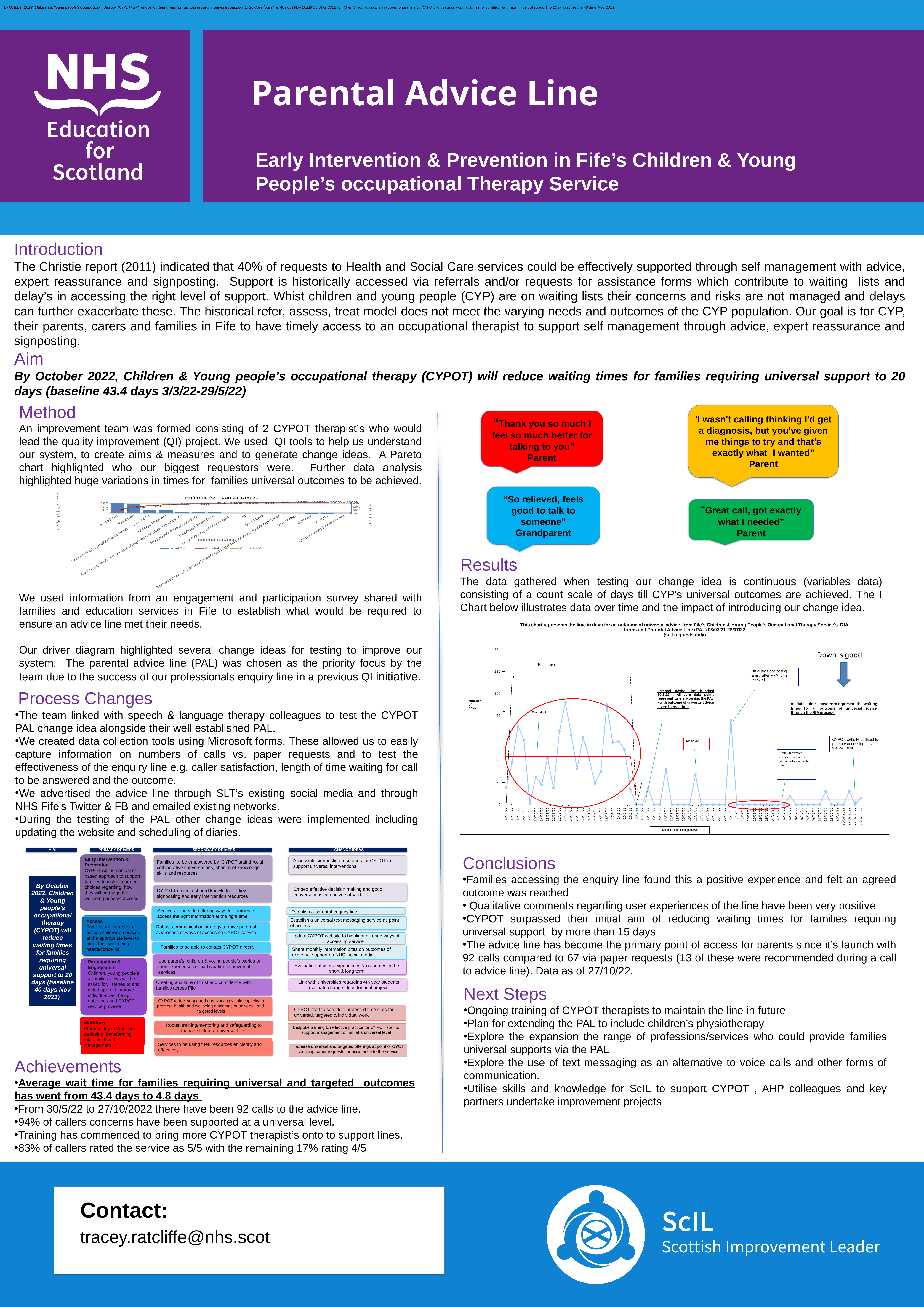
What kind of chart is the chart in the Results section showing time in days for an outcome of universal advice? line chart In the Referrals (OT) Jan 21-Dec 21 chart, how many series does the legend list? 3 In the Referrals (OT) Jan 21-Dec 21 chart, which referral source has the highest number of referrals? Self-referral What is the x-axis label of the Results chart? Date of request In the Results chart, what is the difference between the baseline mean and the post-launch mean? 38.6 What is the title of the chart in the Method section? Referrals (OT) Jan 21-Dec 21 In the Results chart, what is the mean of the baseline data? 43.4 In the Referrals (OT) Jan 21-Dec 21 chart, is the bar for Self-referral greater or less than 60? greater In the Results chart, do the values generally rise or fall over time along the x axis? fall In the Results chart, which is larger: the baseline mean or the mean after the Parental Advice Line launch? the baseline mean (43.4) In the Results chart, what is the highest value shown on the y axis? 140 In the Results chart, what is the mean after the Parental Advice Line was launched? 4.8